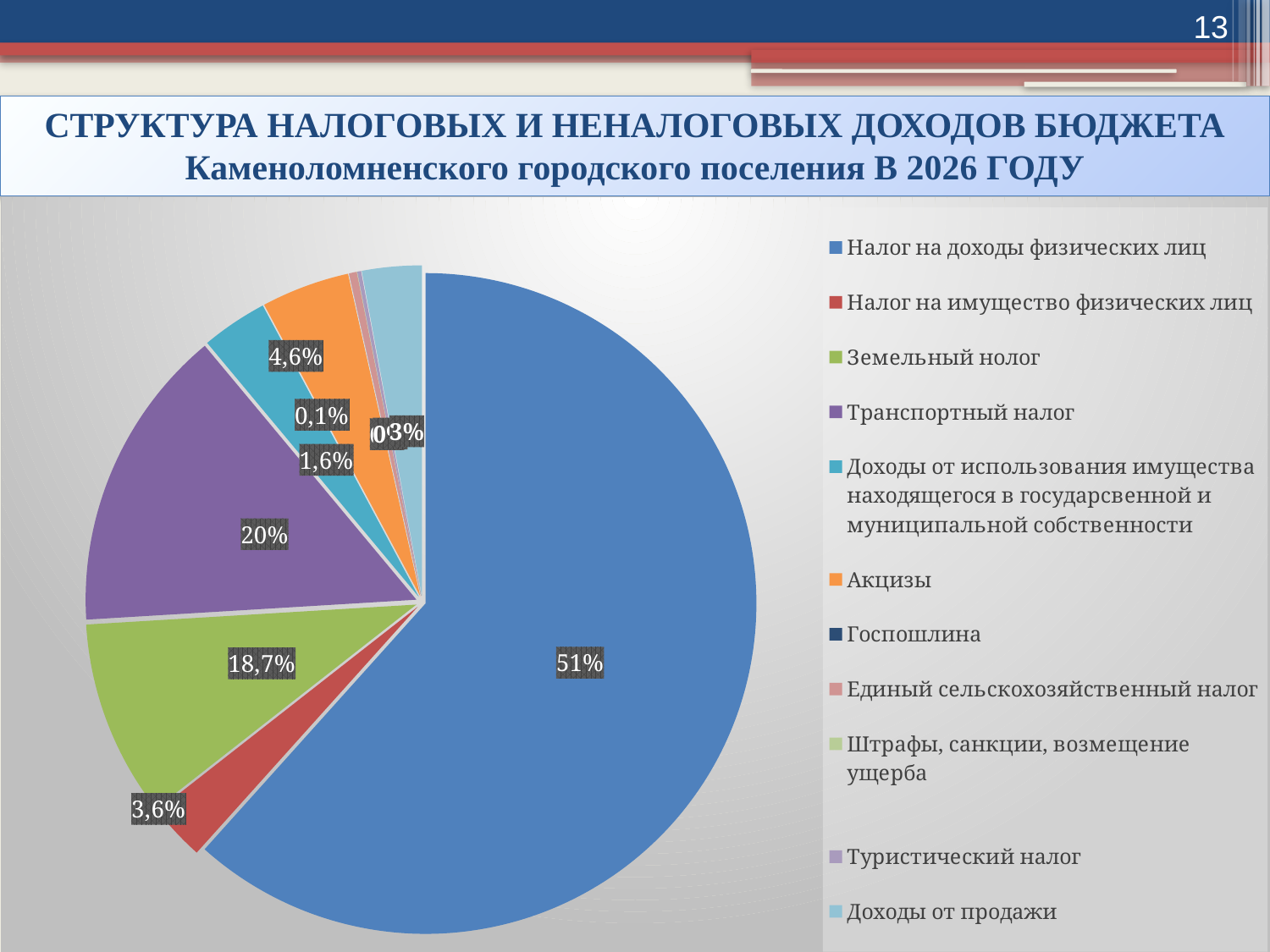
What is the difference between the shares of "Налог на доходы физических лиц" and "Транспортный налог"? 31 percentage points What share of the pie does "Налог на доходы физических лиц" have? 51% Which category has the largest slice of the pie? Налог на доходы физических лиц What is the value shown for "Земельный нолог"? 18,7% How many entries does the legend list? 11 What is the value shown for "Транспортный налог"? 20% What colour is the slice for "Налог на доходы физических лиц"? blue What is the value shown for "Налог на имущество физических лиц"? 3,6% Which is larger, "Транспортный налог" or "Земельный нолог"? Транспортный налог What kind of chart is shown on the slide? pie chart Which year does the chart title refer to? 2026 What is the value shown for "Акцизы"? 4,6%